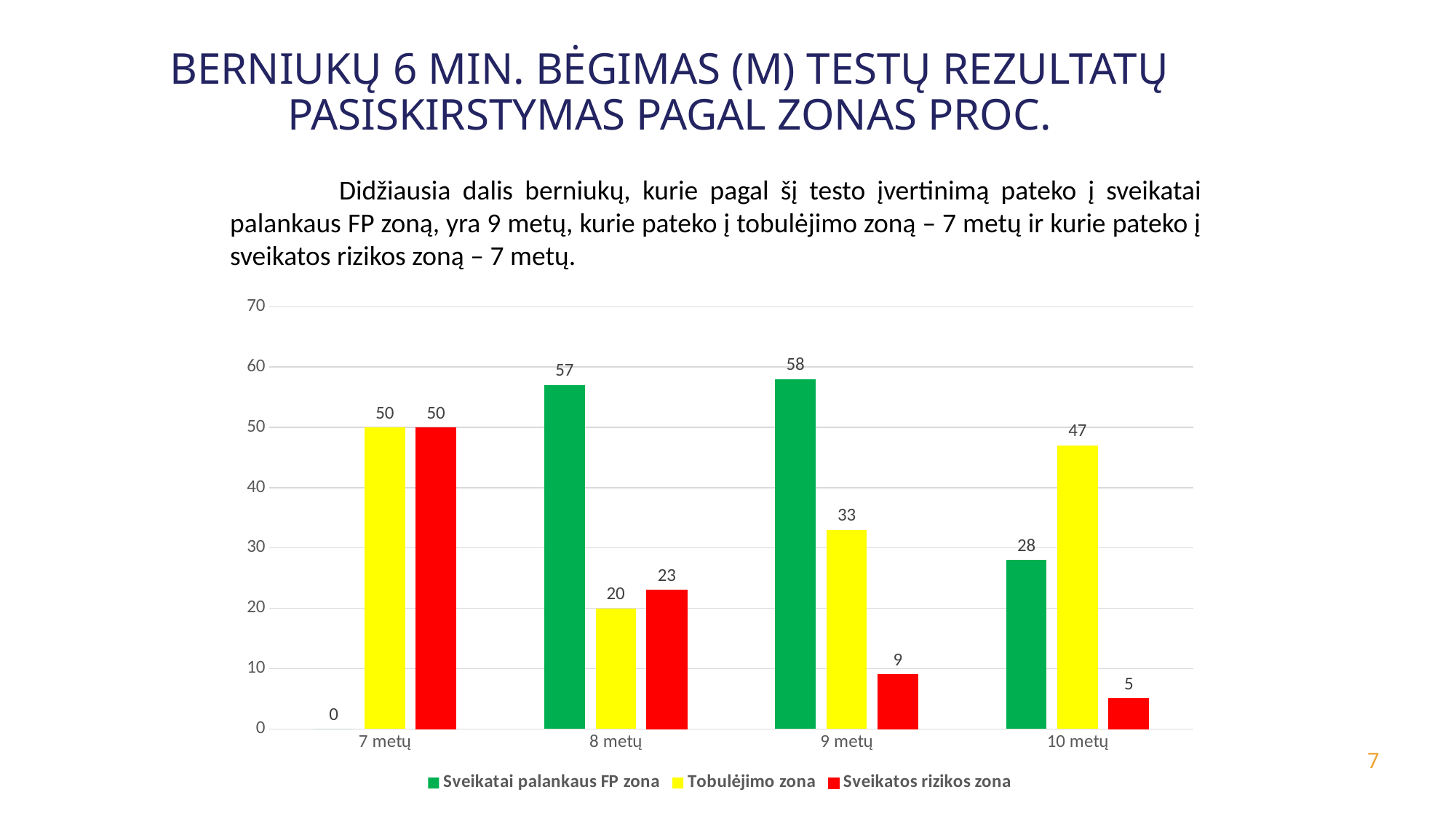
What is the value for Tobulėjimo zona at 10 metų? 47 Which age group has the lowest value for Sveikatos rizikos zona? 10 metų Do the Sveikatos rizikos zona values rise or fall from 8 metų to 10 metų? Fall How many age groups are shown on the x axis? 4 What is the value for Sveikatai palankaus FP zona at 9 metų? 58 What kind of chart is shown on the slide? Bar chart What is the difference between the Sveikatai palankaus FP zona and Tobulėjimo zona values at 8 metų? 37 At 10 metų, which is larger: Tobulėjimo zona or Sveikatai palankaus FP zona? Tobulėjimo zona What is the value for Sveikatos rizikos zona at 8 metų? 23 Which age group has the highest value for Sveikatai palankaus FP zona? 9 metų What is the value for Sveikatai palankaus FP zona at 7 metų? 0 How many series does the legend list? 3